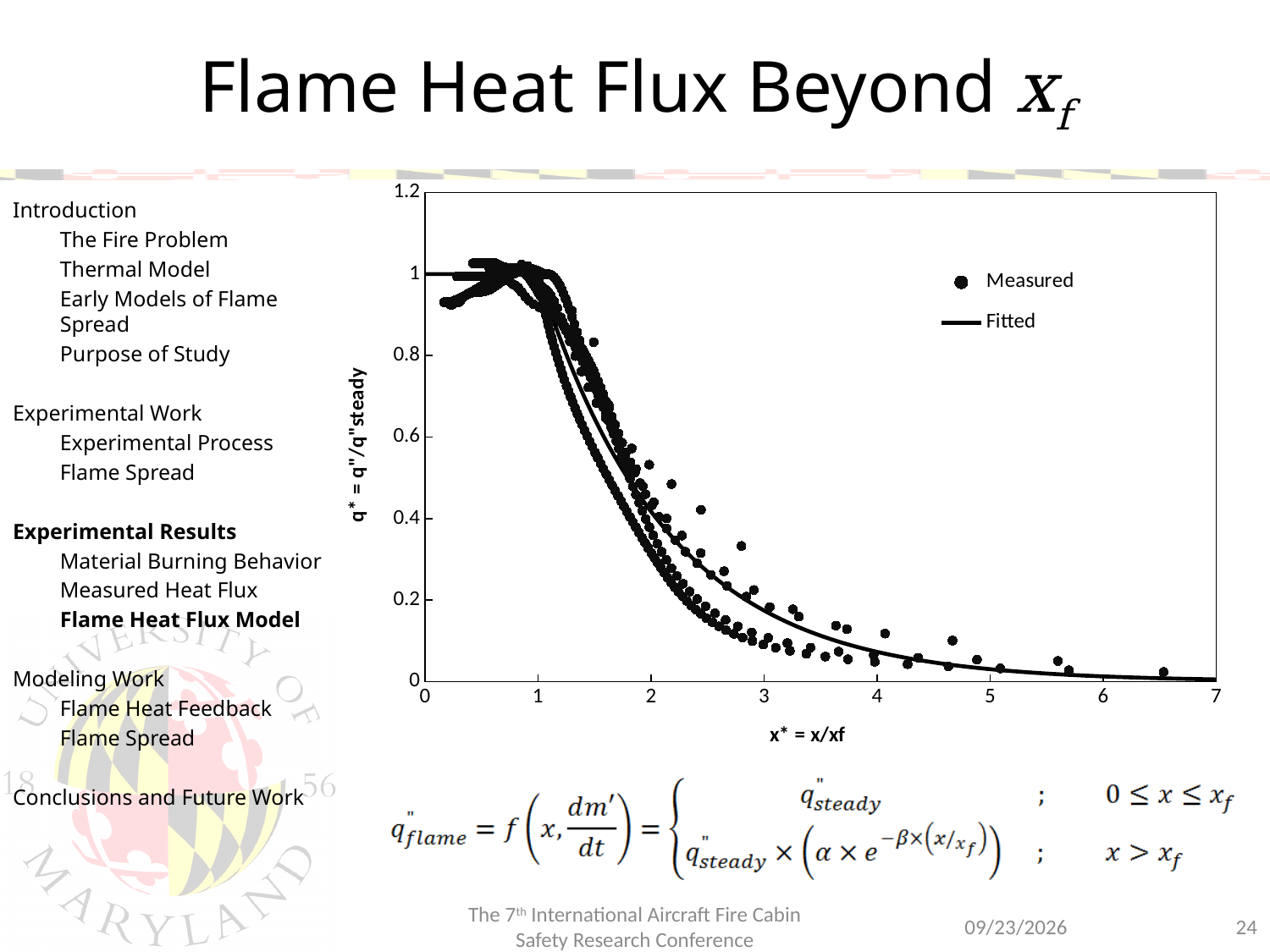
What kind of chart is shown on the slide? Scatter chart with a fitted line Is the value of the Fitted curve at x* = 5 greater or less than 0.2? less What is the maximum value shown on the y axis of the chart? 1.2 How many series does the chart legend list? 2 Do the plotted values rise or fall as x* increases beyond 1? Fall Is the value of the Fitted curve at x* = 4 greater or less than 0.2? less Is the value of the Fitted curve at x* = 1.5 greater or less than 0.6? greater What are the two series named in the chart legend? Measured and Fitted What is the label of the x axis of the chart? x* = x/xf